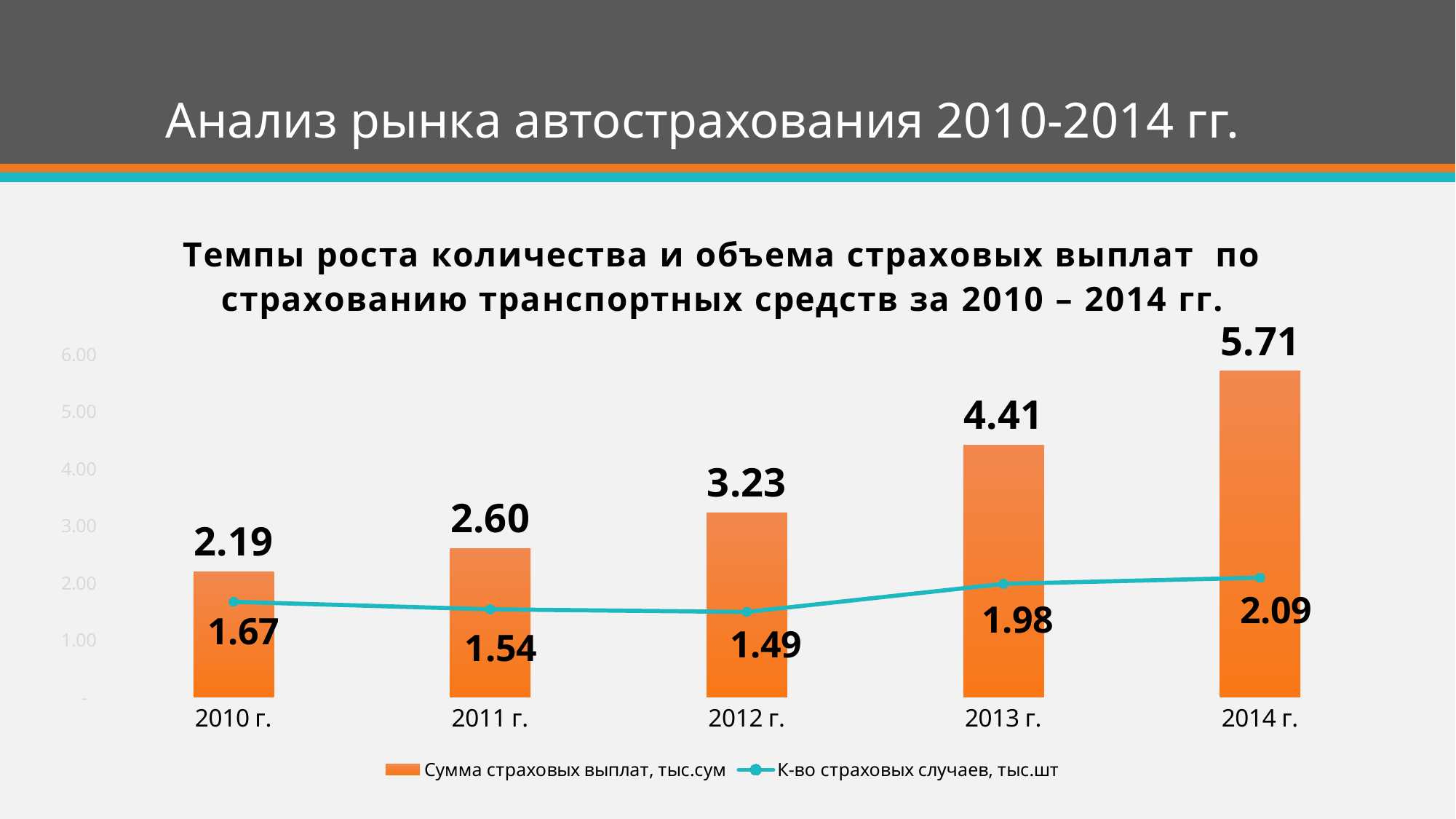
What is the value of 'К-во страховых случаев, тыс.шт' for 2012 г.? 1.49 What kind of chart is this? Combined bar and line chart What is the value of 'Сумма страховых выплат, тыс.сум' for 2011 г.? 2.60 Is the value of 'Сумма страховых выплат, тыс.сум' for 2012 г. greater or less than 3.00? greater How many series does the legend list? 2 How many years are shown on the x axis? 5 What is the difference between the 'Сумма страховых выплат, тыс.сум' values for 2014 г. and 2013 г.? 1.30 What is the value of 'Сумма страховых выплат, тыс.сум' for 2014 г.? 5.71 Which year has the lowest value for 'К-во страховых случаев, тыс.шт'? 2012 г. Which year has the highest value for 'Сумма страховых выплат, тыс.сум'? 2014 г. Which is larger: 'К-во страховых случаев, тыс.шт' for 2013 г. or for 2010 г.? 2013 г. Do the 'Сумма страховых выплат, тыс.сум' values rise or fall from 2010 г. to 2014 г.? rise